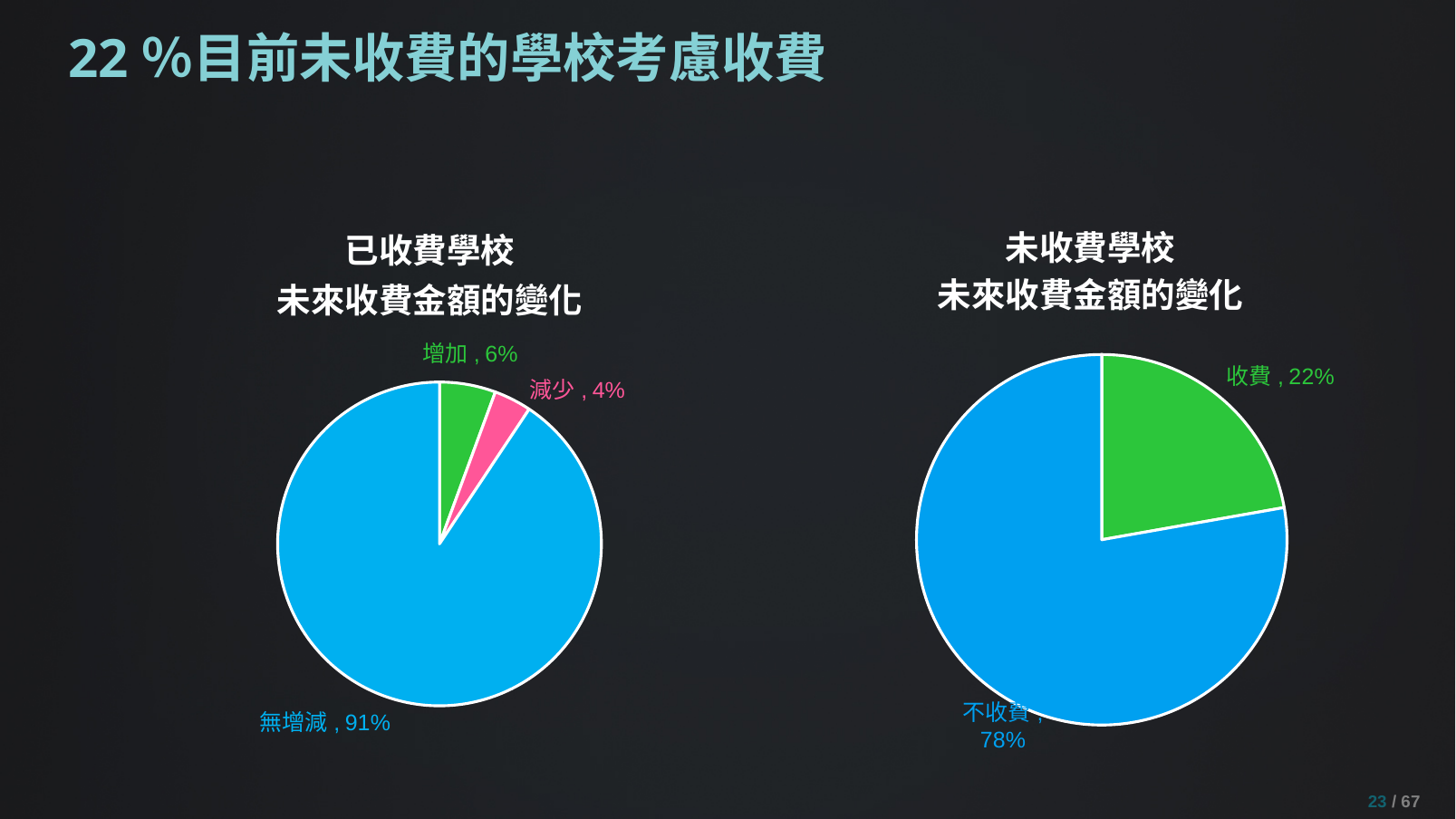
What type of chart is the right chart titled 未收費學校 未來收費金額的變化? Pie chart In the right chart titled 未收費學校 未來收費金額的變化, what is the share for 收費? 22% What is the title of the slide? 22 %目前未收費的學校考慮收費 In the left chart titled 已收費學校 未來收費金額的變化, what is the share for 減少? 4% In the right chart titled 未收費學校 未來收費金額的變化, what is the share for 不收費? 78% In the left chart titled 已收費學校 未來收費金額的變化, which category has the largest slice? 無增減 In the left chart titled 已收費學校 未來收費金額的變化, what is the share for 無增減? 91% How many slices does the left chart titled 已收費學校 未來收費金額的變化 have? 3 In the left chart titled 已收費學校 未來收費金額的變化, which category has the smallest slice? 減少 In the left chart titled 已收費學校 未來收費金額的變化, which is larger, 增加 or 減少? 增加 In the left chart titled 已收費學校 未來收費金額的變化, what is the share for 增加? 6% In the right chart titled 未收費學校 未來收費金額的變化, what is the difference between 不收費 and 收費? 56%